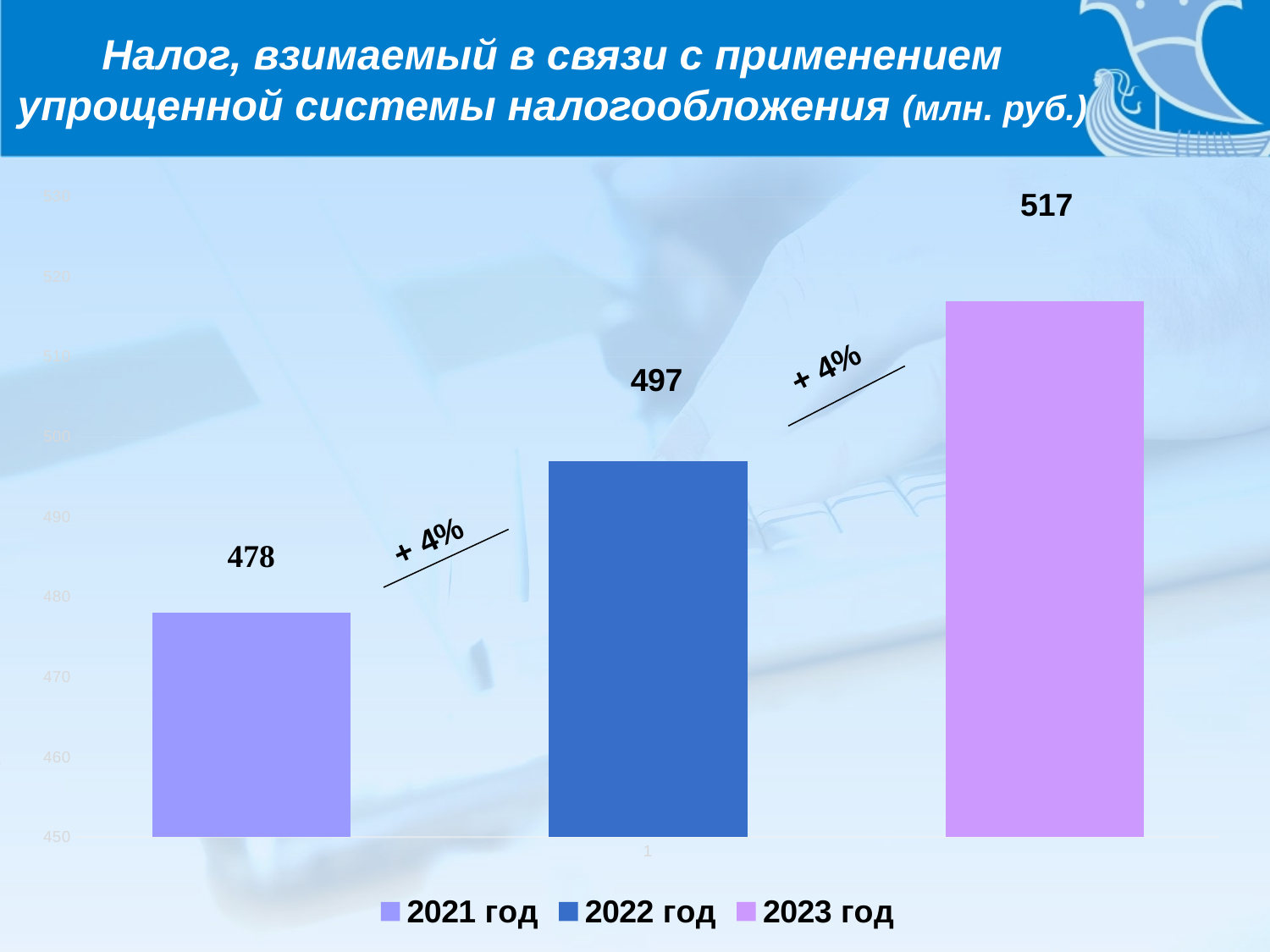
Which year has the highest value? 2023 год What percentage change is annotated between the 2022 год and 2023 год bars? + 4% Which year has the lowest value? 2021 год What kind of chart is shown on the slide? bar chart How many series does the legend list? 3 What is the value for 2022 год? 497 What is the value for 2021 год? 478 Which is larger, the value for 2022 год or the value for 2023 год? 2023 год Do the values rise or fall from 2021 год to 2023 год? rise What is the value for 2023 год? 517 What is the difference between the values for 2023 год and 2021 год? 39 What is the difference between the values for 2022 год and 2021 год? 19